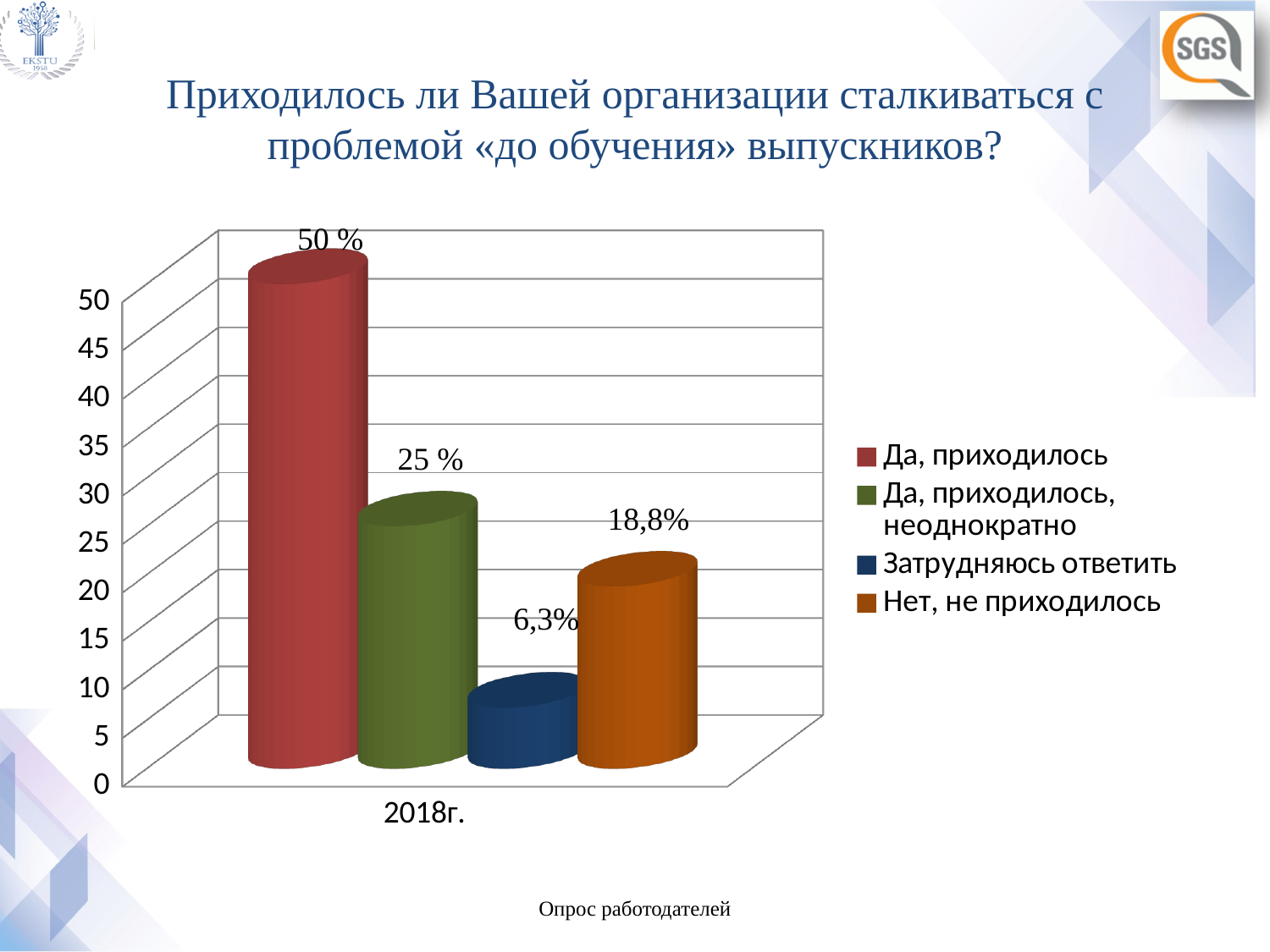
What is the value for «Да, приходилось, неоднократно» in 2018г.? 25 % What is the value for «Затрудняюсь ответить» in 2018г.? 6,3% Which response has the lowest value? Затрудняюсь ответить What is the value for «Нет, не приходилось» in 2018г.? 18,8% Which is larger: «Нет, не приходилось» or «Да, приходилось, неоднократно»? Да, приходилось, неоднократно What is the difference between «Да, приходилось» and «Да, приходилось, неоднократно»? 25 % What is the difference between «Нет, не приходилось» and «Затрудняюсь ответить»? 12,5% What is the value for «Да, приходилось» in 2018г.? 50 % How many series does the legend list? 4 What colour is the bar for «Затрудняюсь ответить»? Blue Which response has the highest value? Да, приходилось What kind of chart is shown on the slide? Bar chart